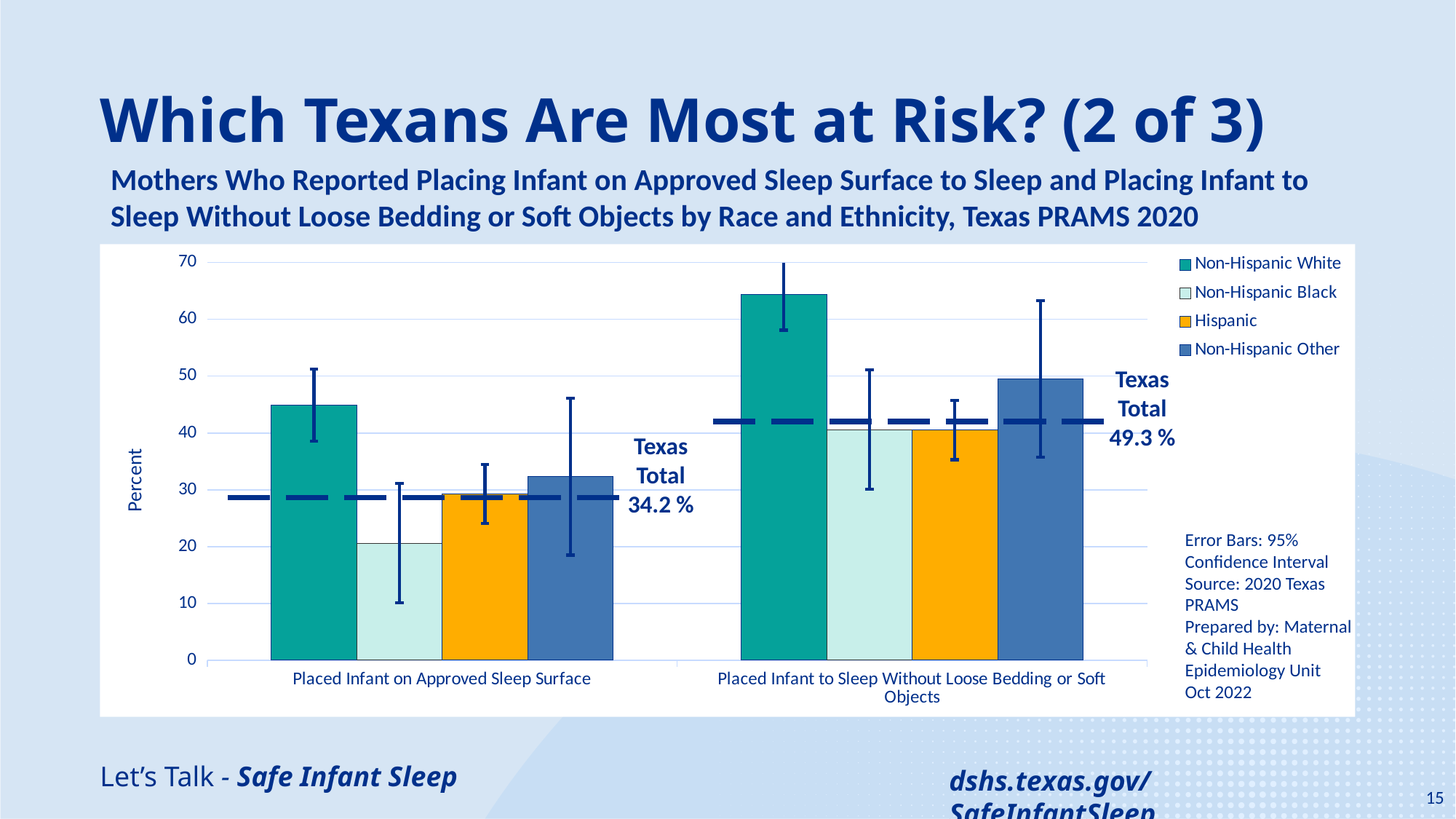
What is the Texas Total printed for "Placed Infant to Sleep Without Loose Bedding or Soft Objects"? 49.3 % Which race/ethnicity group has the lowest bar for "Placed Infant on Approved Sleep Surface"? Non-Hispanic Black Is the Non-Hispanic White value for "Placed Infant to Sleep Without Loose Bedding or Soft Objects" greater or less than 60? greater Which race/ethnicity group has the highest bar for "Placed Infant to Sleep Without Loose Bedding or Soft Objects"? Non-Hispanic White For "Placed Infant on Approved Sleep Surface", which is larger: the Non-Hispanic White bar or the Non-Hispanic Other bar? Non-Hispanic White What kind of chart is shown on the slide? bar chart Which race/ethnicity group has the highest bar for "Placed Infant on Approved Sleep Surface"? Non-Hispanic White How many series does the legend list? 4 What does the note on the slide say the error bars represent? 95% Confidence Interval How many categories are shown on the x axis? 2 What is the Texas Total printed for "Placed Infant on Approved Sleep Surface"? 34.2 % Is the Non-Hispanic Black value for "Placed Infant on Approved Sleep Surface" greater or less than 30? less